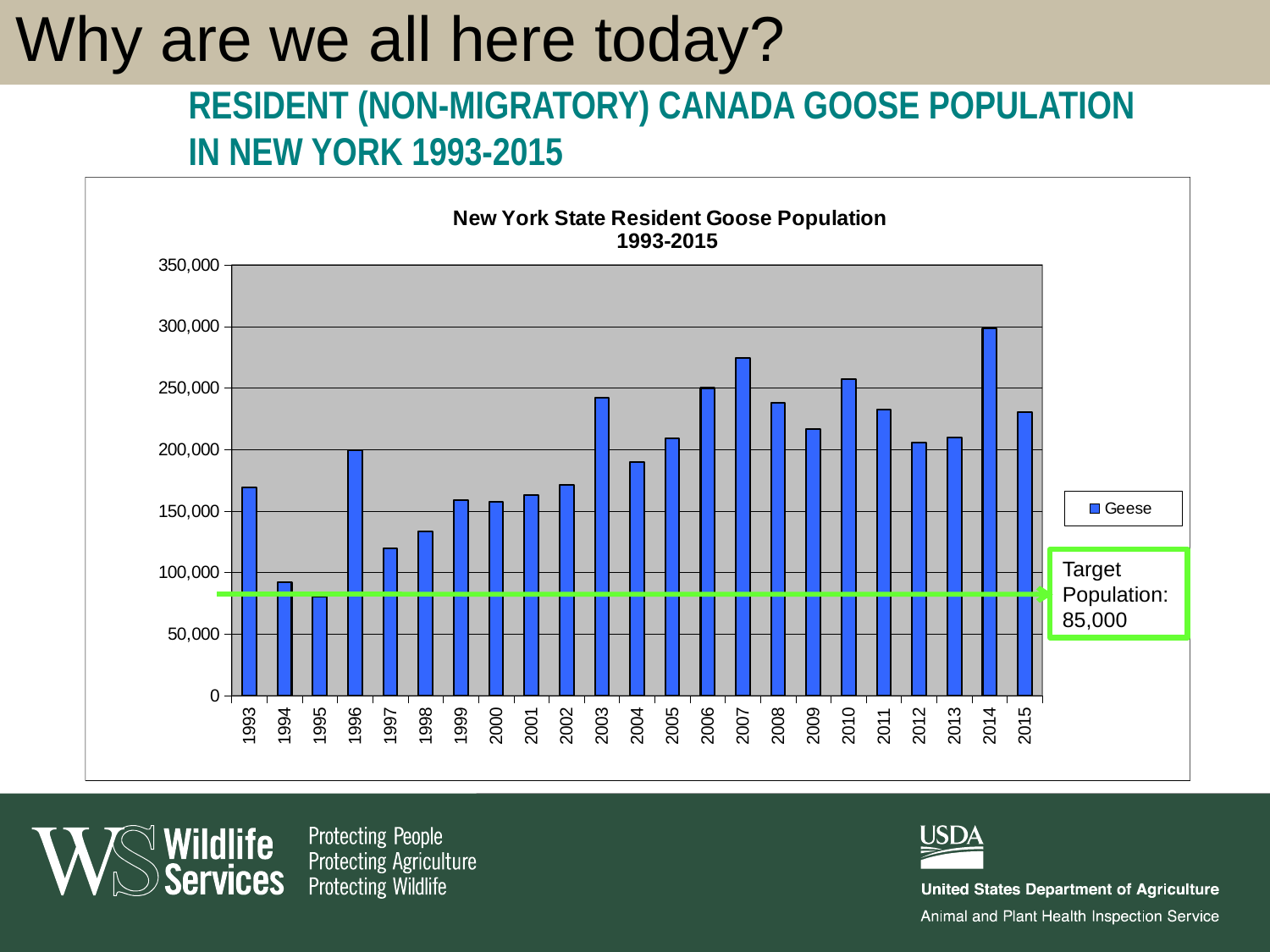
Is the value for 1993 greater or less than 150,000? greater Which year has the larger goose population, 2007 or 2010? 2007 Is the value for 1997 greater or less than 150,000? less What is the name of the series shown in the legend? Geese How many series does the chart's legend list? 1 How many years (bars) are plotted on the chart? 23 Is the value for 2007 greater or less than 250,000? greater Which year has the highest resident goose population? 2014 Which year has the lowest resident goose population? 1995 What kind of chart is shown on the slide? bar chart What target population is indicated by the green line on the chart? 85,000